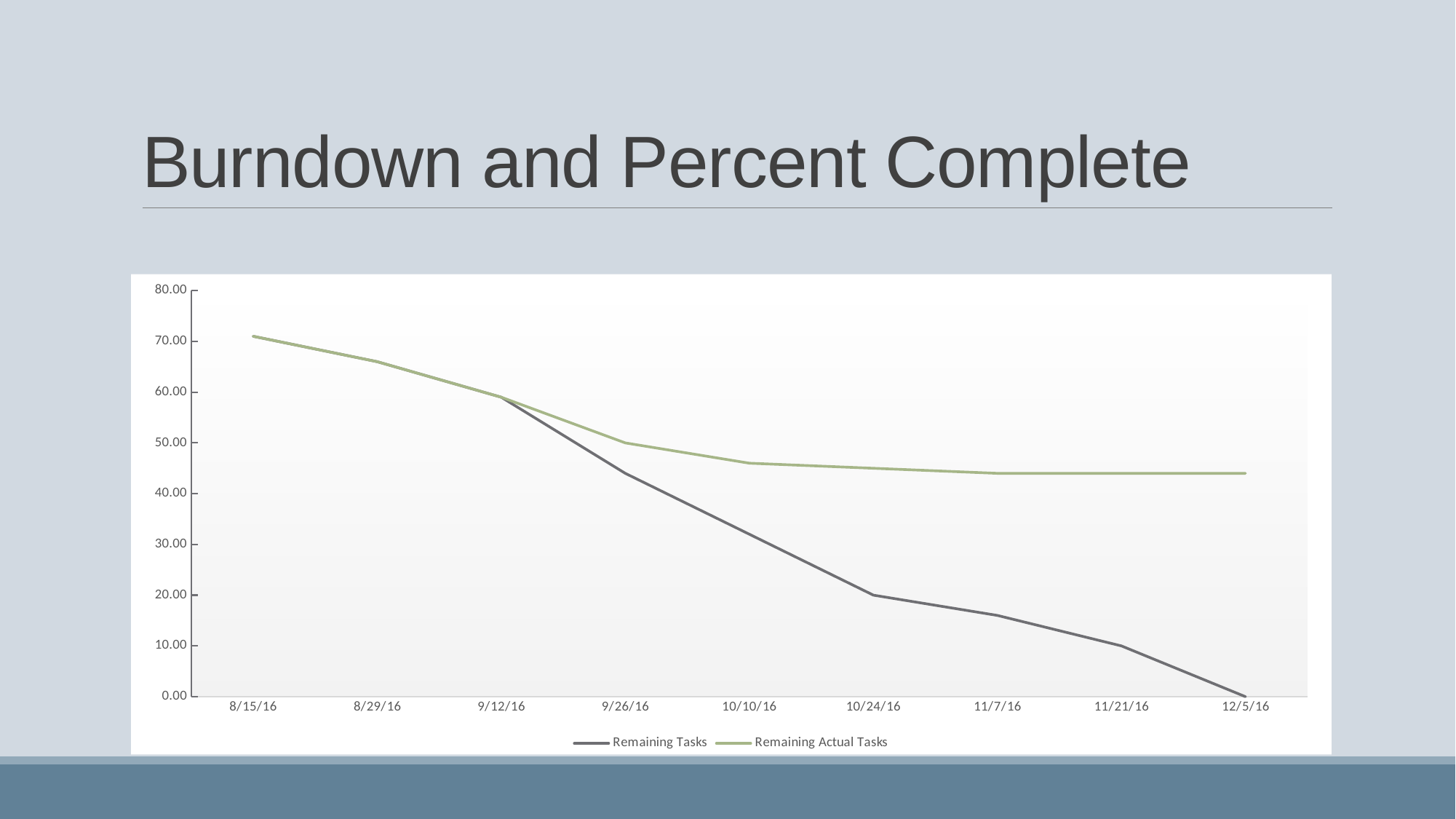
What is the title of the slide containing the chart? Burndown and Percent Complete On which date is Remaining Tasks at its highest? 8/15/16 Is the value for Remaining Tasks on 11/21/16 greater or less than 20.00? less On which date is Remaining Tasks at its lowest? 12/5/16 How many series does the legend list? 2 Is the value for Remaining Actual Tasks on 10/10/16 greater or less than 50.00? less What is the value of Remaining Tasks on 12/5/16? 0.00 What kind of chart is shown on the slide? line chart How many dates are shown on the x axis? 9 On 12/5/16, which series has the higher value, Remaining Tasks or Remaining Actual Tasks? Remaining Actual Tasks Do the values for Remaining Tasks rise or fall from 8/15/16 to 12/5/16? fall Is the value for Remaining Actual Tasks on 12/5/16 greater or less than 40.00? greater